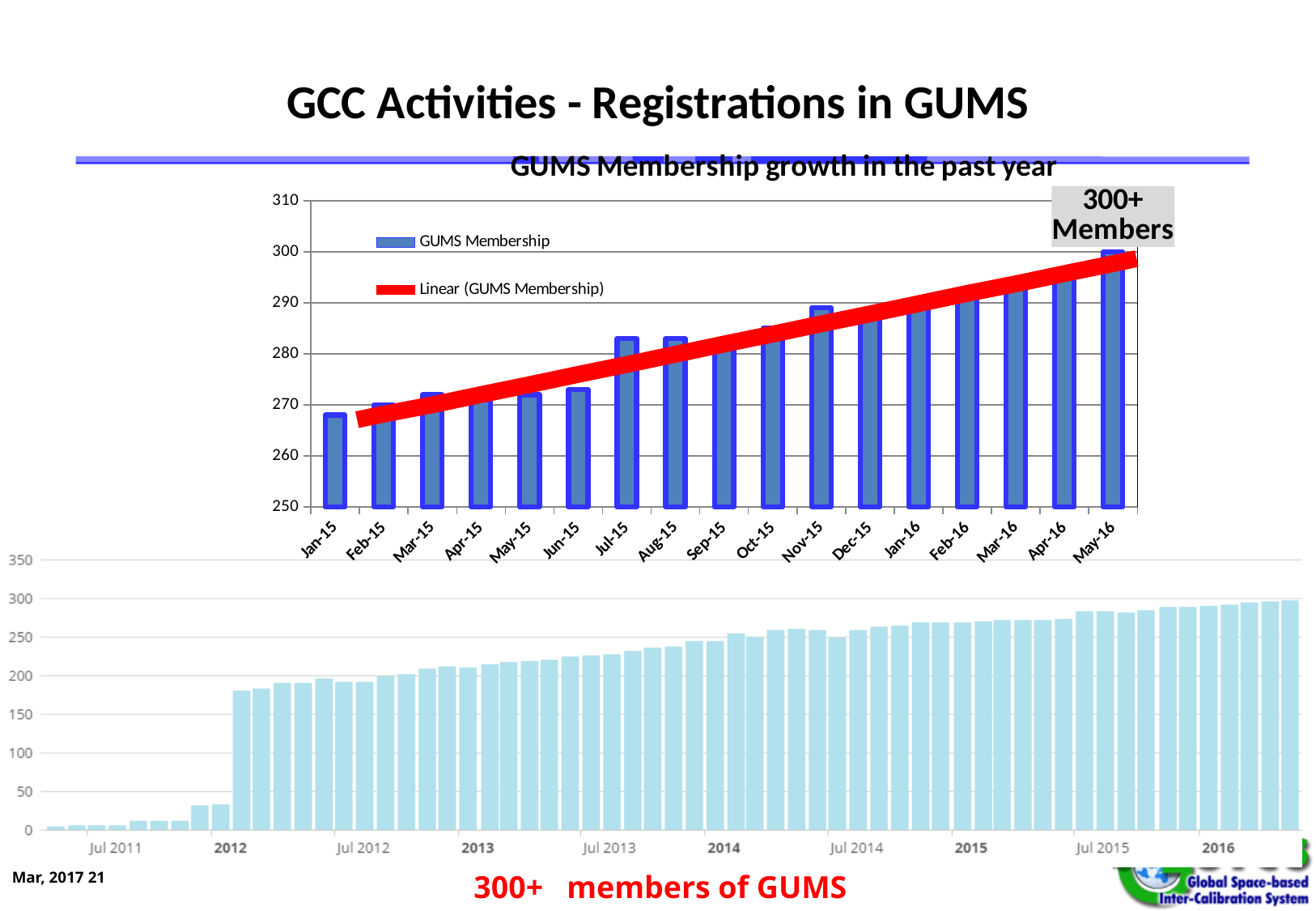
In the top chart 'GUMS Membership growth in the past year', is the value for Jul-15 greater or less than 280? greater What kind of chart is the top chart titled 'GUMS Membership growth in the past year'? bar chart In the top chart 'GUMS Membership growth in the past year', how many months are shown on the x axis? 17 In the top chart 'GUMS Membership growth in the past year', what colour is the linear trend line? red In the top chart 'GUMS Membership growth in the past year', is the value for Nov-15 greater or less than 280? greater In the top chart 'GUMS Membership growth in the past year', which is larger, the value for Jun-15 or the value for Jul-15? Jul-15 In the top chart 'GUMS Membership growth in the past year', which month has the highest membership? May-16 In the top chart 'GUMS Membership growth in the past year', how many entries does the legend list? 2 In the top chart 'GUMS Membership growth in the past year', do the membership values generally rise or fall from Jan-15 to May-16? rise In the bottom chart, is the value at the Jul 2011 tick greater or less than 50? less In the top chart 'GUMS Membership growth in the past year', which month has the lowest membership? Jan-15